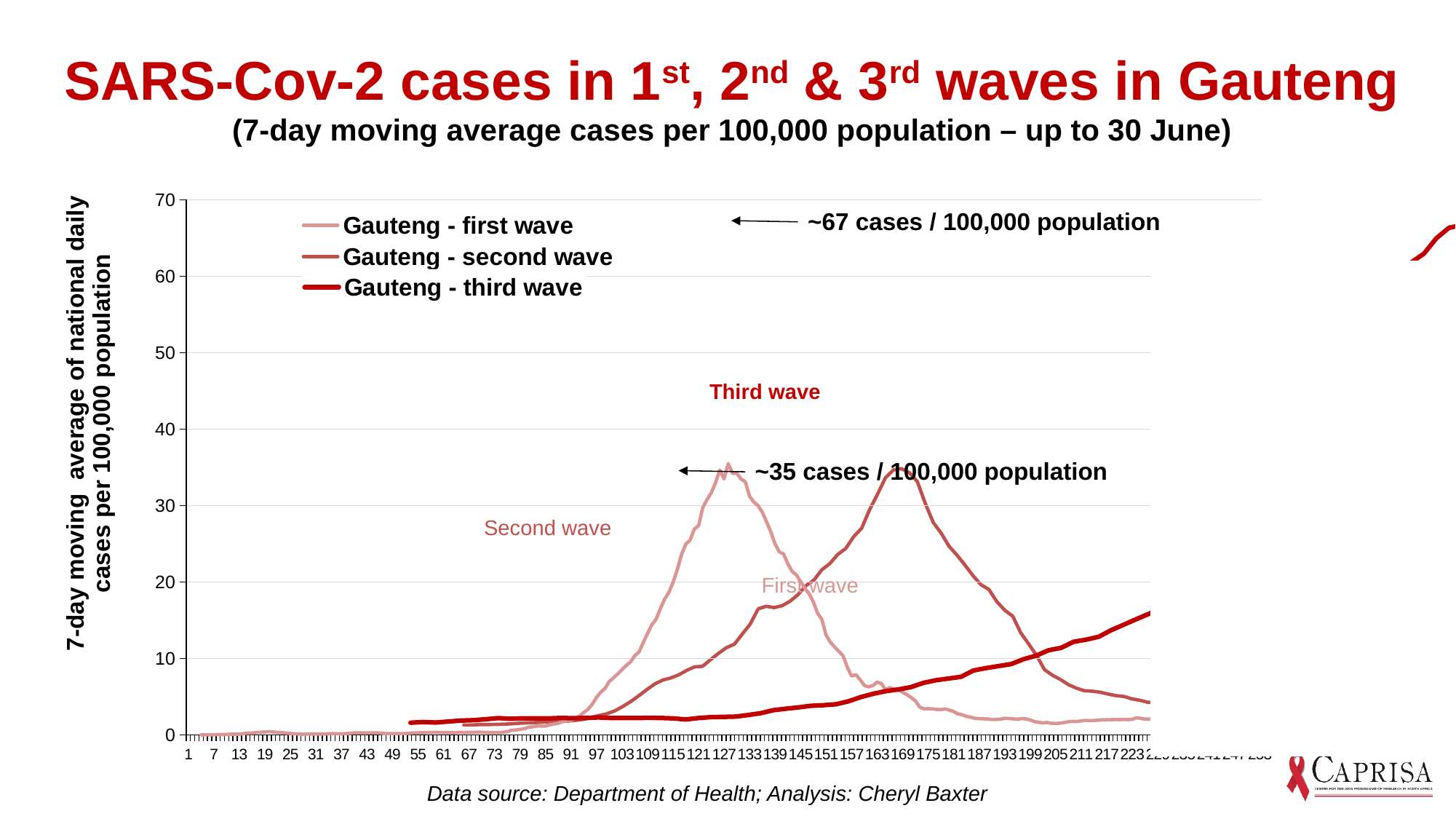
Is the peak value of the Gauteng - first wave line greater or less than 30? greater Does the Gauteng - third wave line rise or fall along the x axis? rise What are the three series named in the legend? Gauteng - first wave, Gauteng - second wave, Gauteng - third wave At the right-hand end of the chart, which is higher: the Gauteng - third wave line or the Gauteng - first wave line? Gauteng - third wave Which series reaches its peak earliest along the x axis? Gauteng - first wave Which series has the lowest peak value on the chart? Gauteng - third wave What kind of chart is shown on the slide? line chart What is the highest value shown on the y axis? 70 Is the value of the Gauteng - third wave line at its right-hand end greater or less than 10? greater Is the value of the Gauteng - third wave line at its right-hand end greater or less than 20? less How many series does the legend list? 3